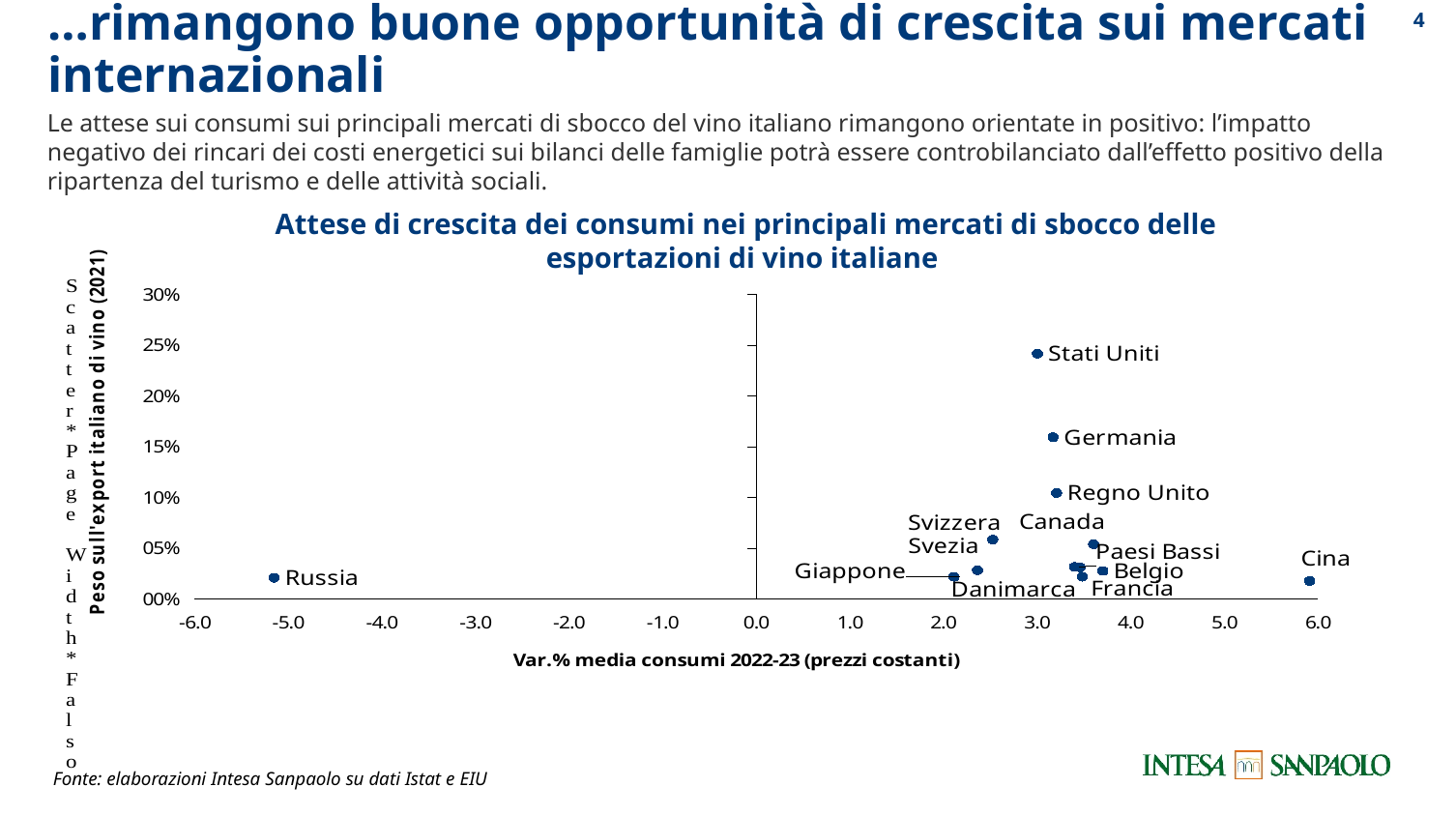
Which country has the highest expected consumption growth (horizontal axis) in the chart? Cina Is the consumption growth value (horizontal axis) for Russia greater or less than -4.0? less Which has a larger share of Italian wine exports (vertical axis), Stati Uniti or Germania? Stati Uniti Which country has the lowest expected consumption growth (horizontal axis) in the chart? Russia Which country has the highest share of Italian wine exports (vertical axis) in the chart? Stati Uniti Which has a higher expected consumption growth (horizontal axis), Russia or Cina? Cina Is the consumption growth value (horizontal axis) for Cina greater or less than 5.0? greater Is the export share (vertical axis) for Regno Unito greater or less than 15%? less What is the label of the horizontal axis of the chart? Var.% media consumi 2022-23 (prezzi costanti) What kind of chart is shown on the slide? scatter chart How many countries are plotted in the chart? 13